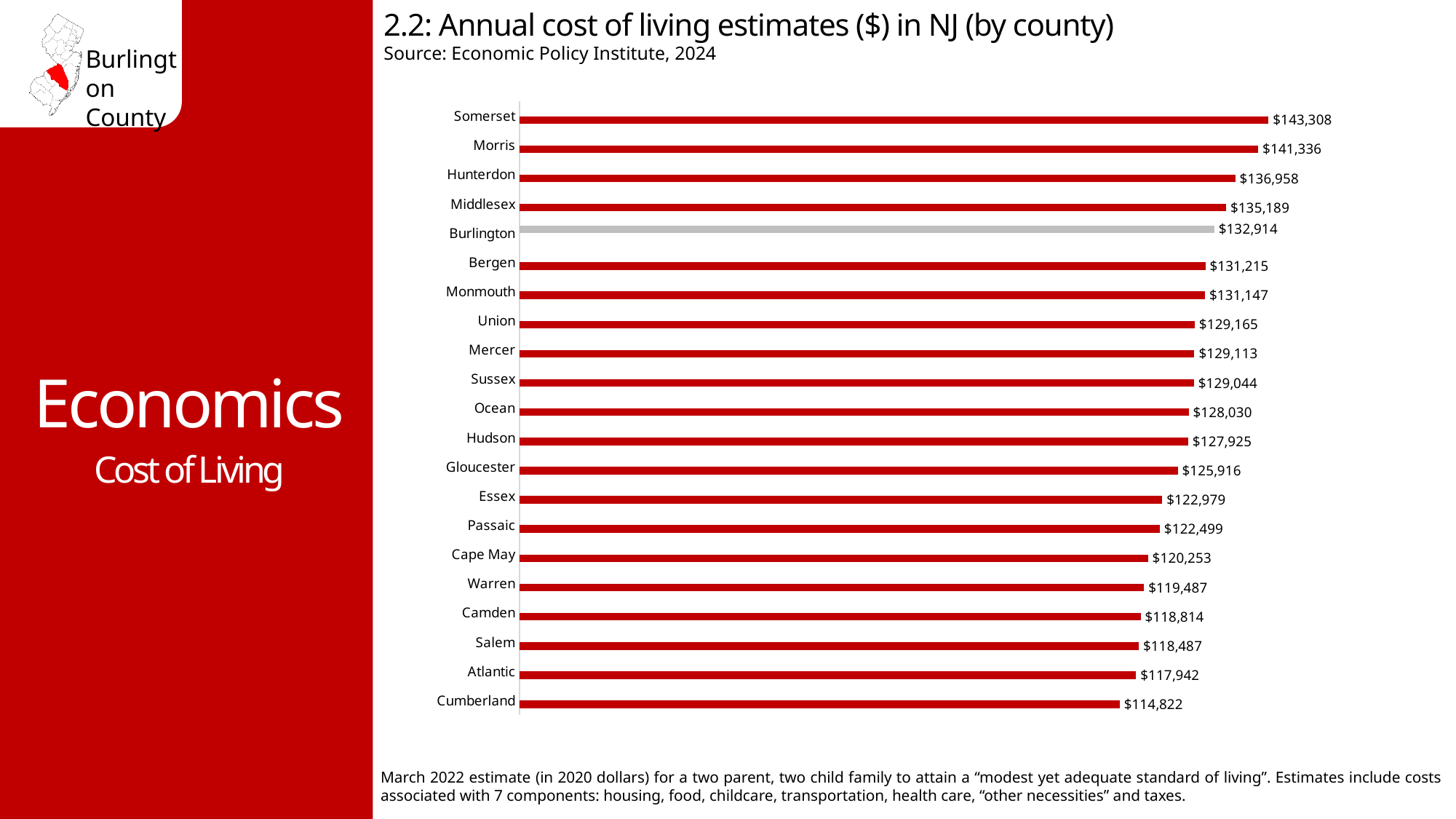
What is the source cited for the chart? Economic Policy Institute, 2024 Which county has a higher cost of living estimate, Hunterdon or Middlesex? Hunterdon What is the annual cost of living estimate for Cape May? $120,253 Which county has a higher cost of living estimate, Essex or Gloucester? Gloucester How many counties are shown in the chart? 21 Which county has the lowest annual cost of living estimate? Cumberland What is the difference between the cost of living estimates for Burlington and Bergen? $1,699 What is the annual cost of living estimate for Burlington County? $132,914 What is the difference between the cost of living estimates for Somerset and Cumberland? $28,486 Which county's bar is shown in grey instead of red? Burlington Which county has the highest annual cost of living estimate? Somerset What type of chart is used to show the annual cost of living estimates? Bar chart